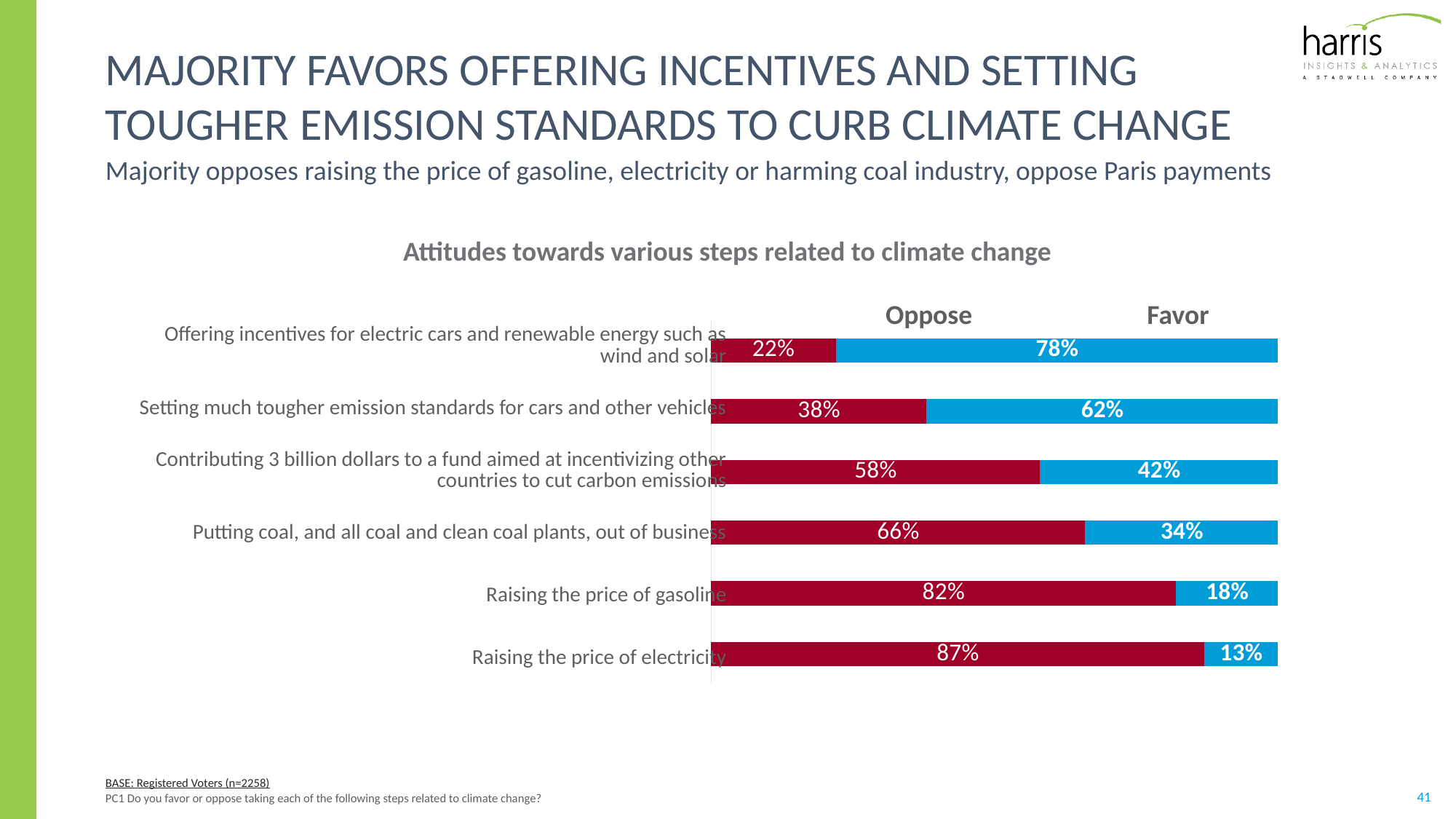
What type of chart is used on this slide? Bar chart What is the title of the chart? Attitudes towards various steps related to climate change What percentage oppose raising the price of electricity? 87% Which is larger: the Favor percentage for setting tougher emission standards or the Favor percentage for putting coal plants out of business? Setting much tougher emission standards for cars and other vehicles How many series does the chart show? 2 Which step has the lowest Favor percentage? Raising the price of electricity Which step has the highest Oppose percentage? Raising the price of electricity What is the difference between the Oppose percentages for raising the price of gasoline and putting coal plants out of business? 16% How many steps related to climate change are shown in the chart? 6 What percentage oppose contributing 3 billion dollars to a fund aimed at incentivizing other countries to cut carbon emissions? 58% What percentage favor offering incentives for electric cars and renewable energy such as wind and solar? 78% What percentage favor setting much tougher emission standards for cars and other vehicles? 62%